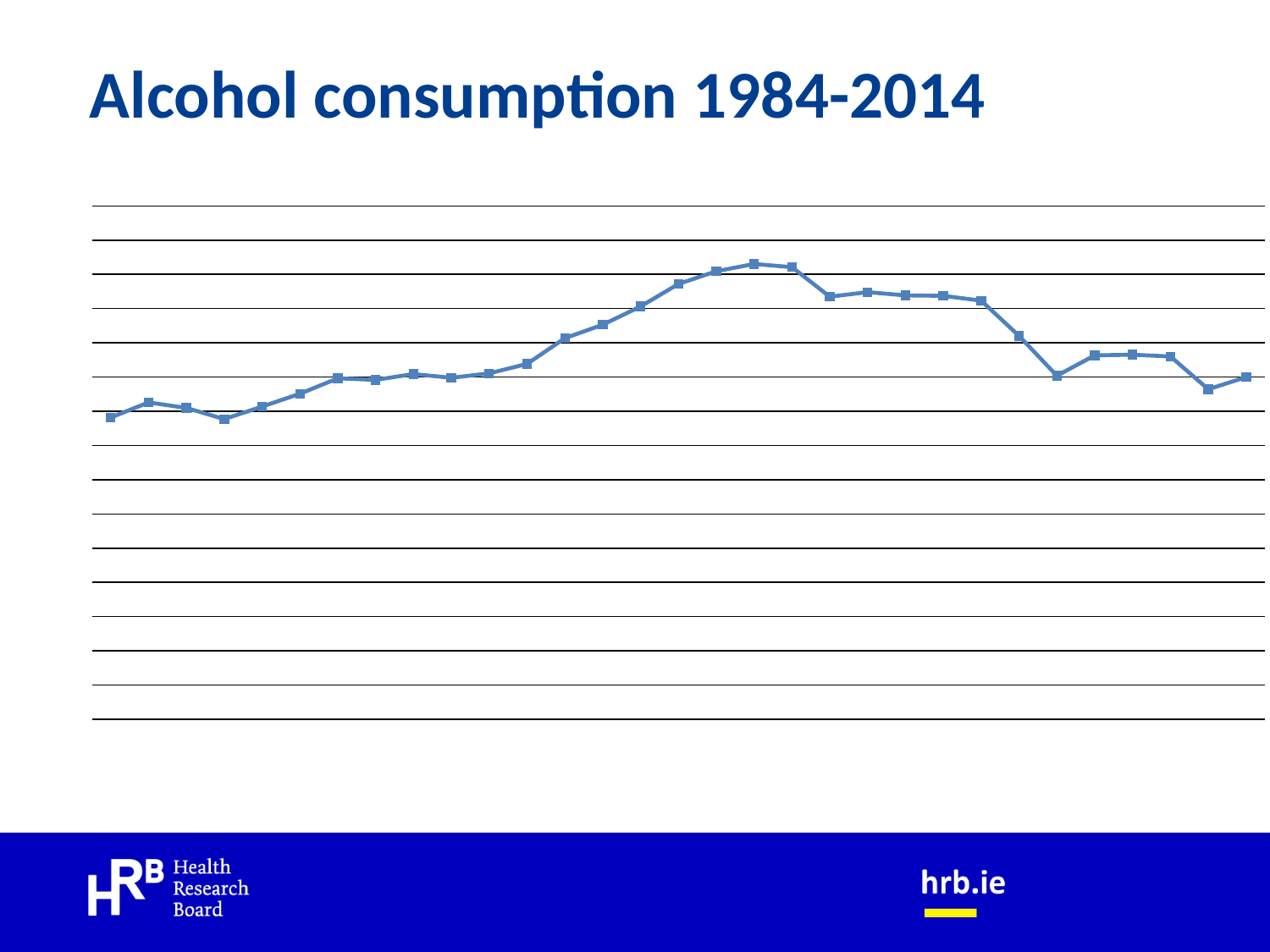
After reaching its peak, does the line generally rise or fall towards the right end of the chart? fall What is the title of the chart? Alcohol consumption 1984-2014 Is the highest point of the line in the left half or the right half of the chart? right half Is the last point on the line higher or lower than the first point? higher What colour is the plotted line? blue Do the values generally rise or fall over the first half of the series? rise How many data points are plotted on the line? 31 What kind of chart is shown on the slide? line chart How many lines (series) are plotted on the chart? 1